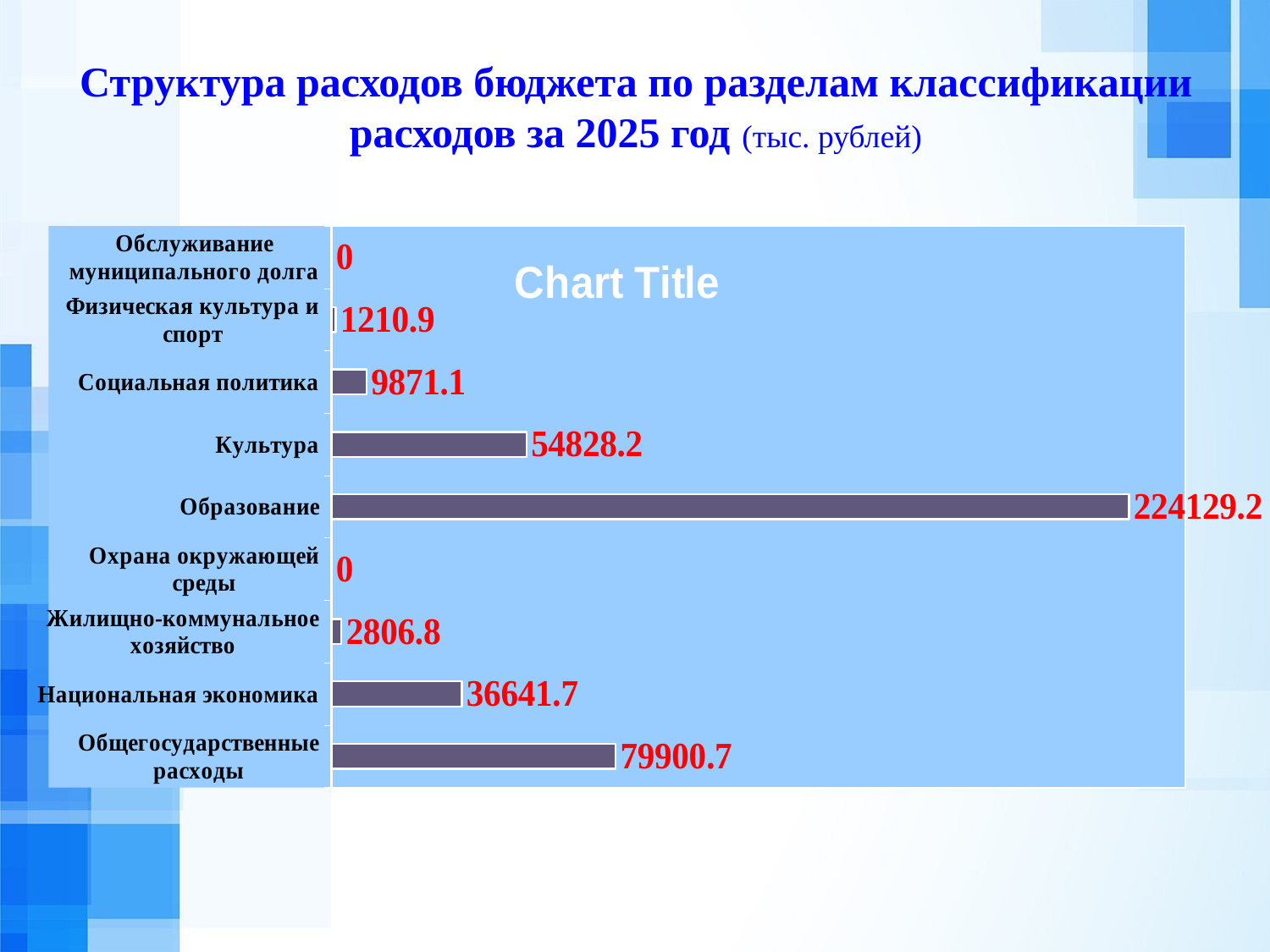
What is the value for Образование? 224129.2 What is the value for Жилищно-коммунальное хозяйство? 2806.8 Which category has the highest value? Образование What is the difference between Образование and Общегосударственные расходы? 144228.5 Which is larger, Социальная политика or Жилищно-коммунальное хозяйство? Социальная политика What kind of chart is shown on the slide? Bar chart What is the value for Физическая культура и спорт? 1210.9 What is the value for Общегосударственные расходы? 79900.7 What is the value for Культура? 54828.2 How many categories are shown in the chart? 9 How many categories have a value of 0? 2 What is the difference between Культура and Национальная экономика? 18186.5